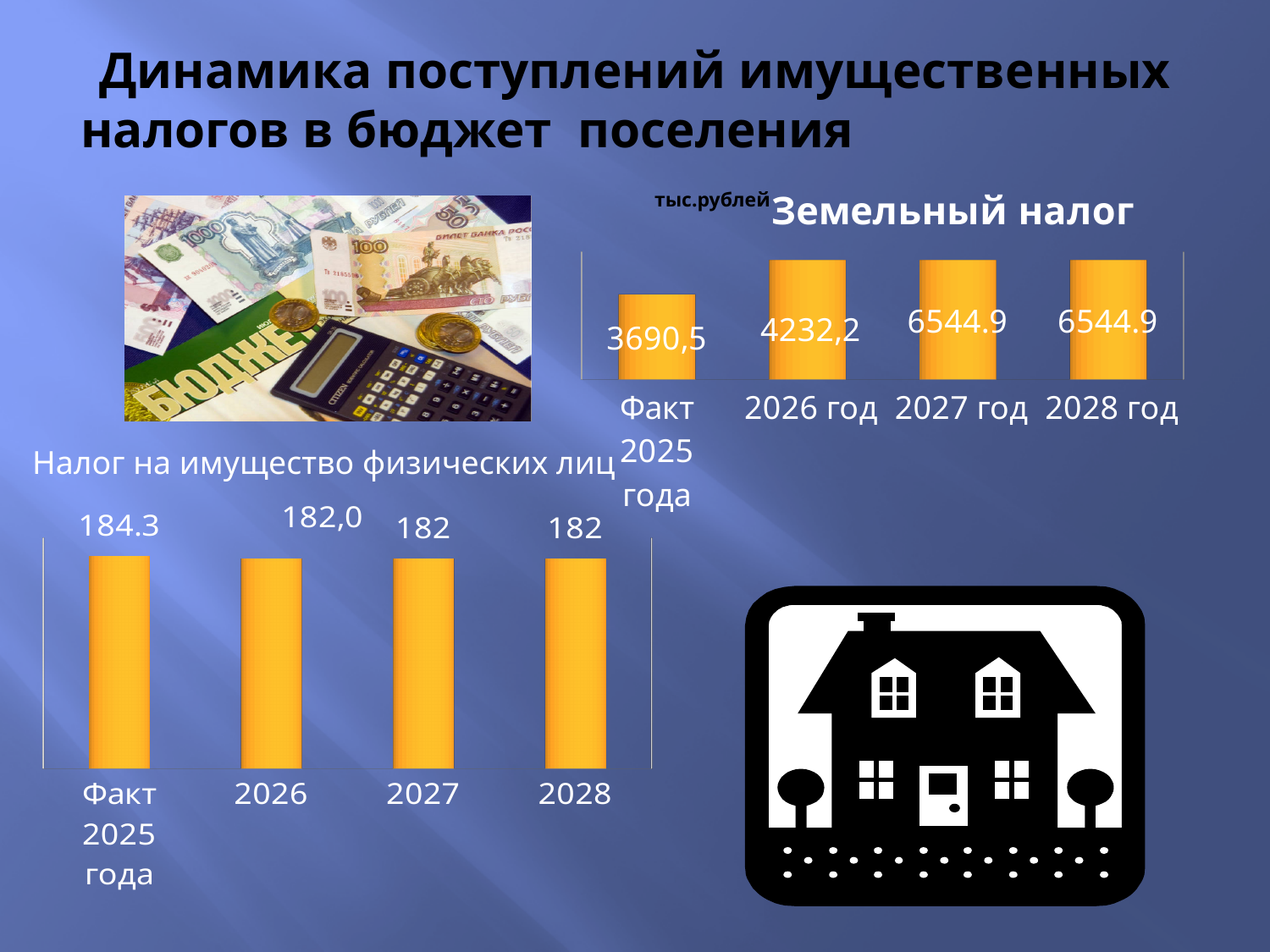
In the Налог на имущество физических лиц chart, what is the value for 2026? 182,0 In the Земельный налог chart, what is the value for Факт 2025 года? 3690,5 In the Земельный налог chart, which category has the lowest value? Факт 2025 года In the Налог на имущество физических лиц chart, which category has the highest value? Факт 2025 года How many bars are in the Налог на имущество физических лиц chart? 4 In the Земельный налог chart, do the values rise or fall from Факт 2025 года to 2028 год? rise In the Земельный налог chart, what is the value for 2026 год? 4232,2 What kind of chart is the Земельный налог chart? bar chart In the Земельный налог chart, which is larger: the value for 2027 год or the value for 2026 год? 2027 год In the Земельный налог chart, what is the difference between the values for 2026 год and Факт 2025 года? 541,7 In the Земельный налог chart, what is the value for 2028 год? 6544.9 In the Налог на имущество физических лиц chart, what is the value for Факт 2025 года? 184.3